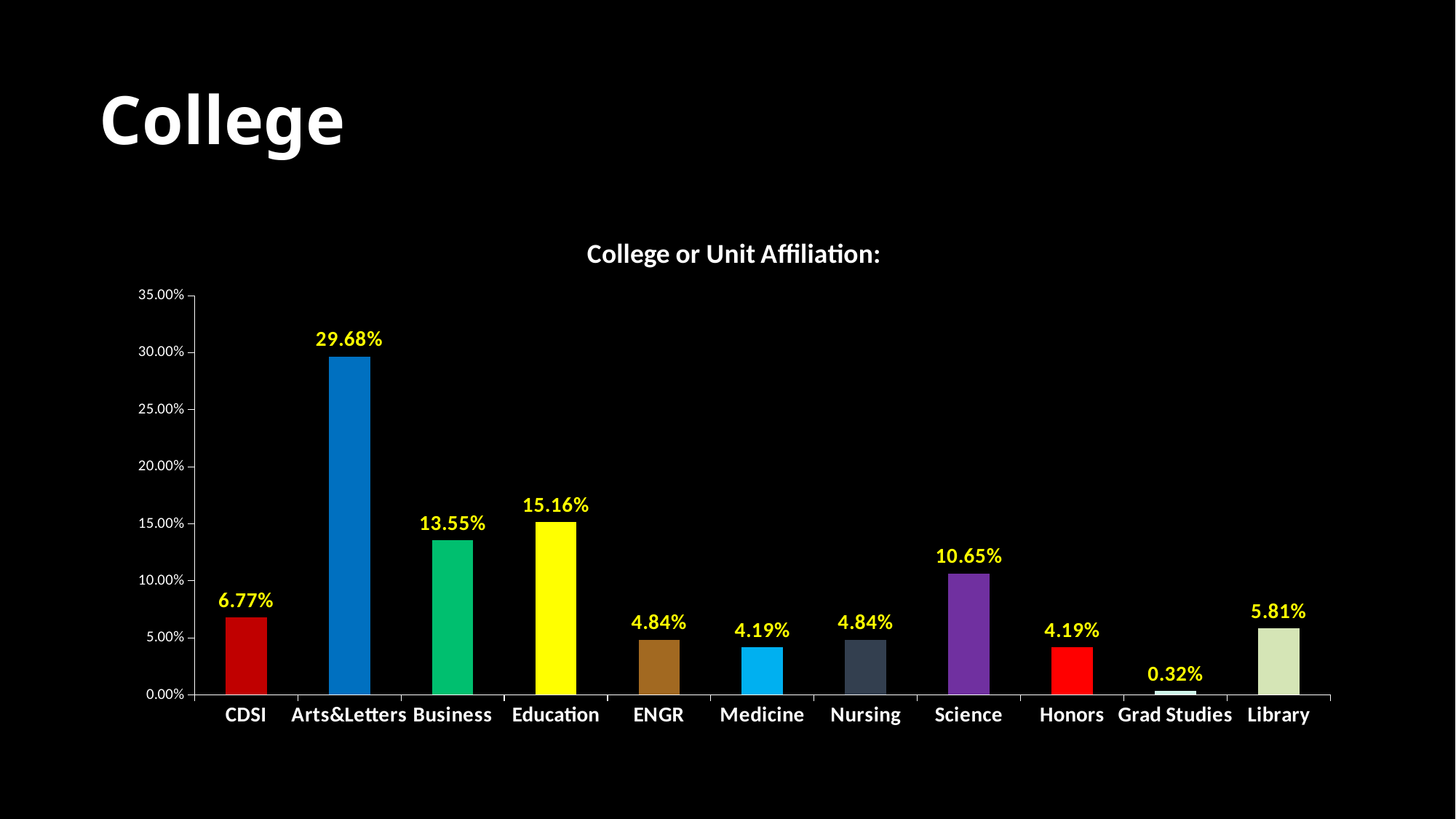
What is the title of the chart? College or Unit Affiliation: Which category has the lowest value? Grad Studies What is the difference between the values for Education and Business? 1.61% What kind of chart is shown on the slide? Bar chart What is the value for Science? 10.65% Which is larger, the value for CDSI or the value for Library? CDSI Which category has the highest value? Arts&Letters What is the value for Grad Studies? 0.32% What is the value for Arts&Letters? 29.68% What is the difference between the values for Arts&Letters and Education? 14.52% How many categories are shown on the x axis? 11 Is the value for Science greater or less than 10.00%? greater